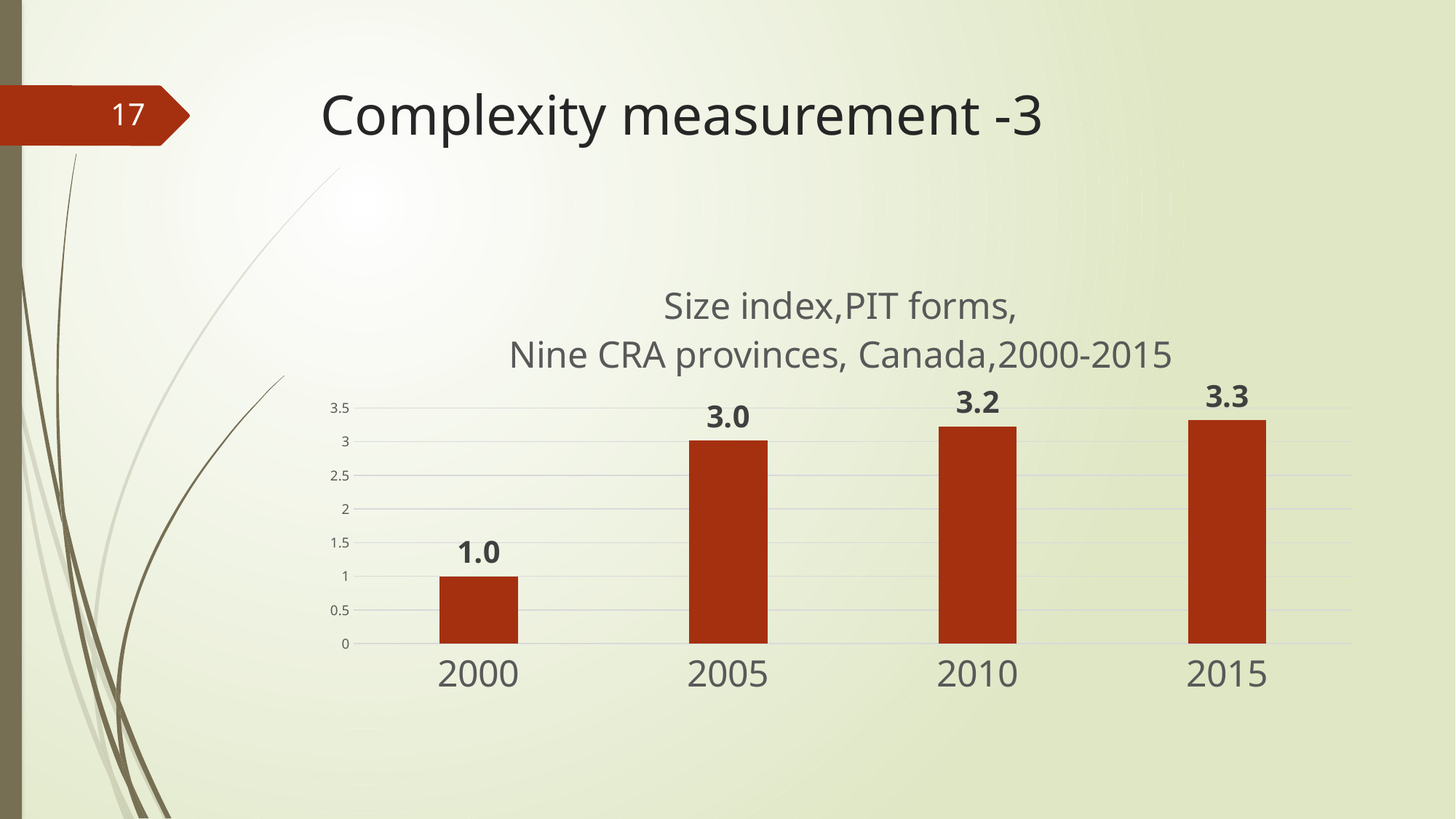
What is the difference between the size index values for 2005 and 2000? 2.0 Which year has the highest size index value? 2015 Which year has a larger size index value, 2000 or 2010? 2010 What is the size index value for 2010? 3.2 What is the size index value for 2005? 3.0 What is the size index value for 2000? 1.0 How many years are shown on the x axis of the chart? 4 Which year has the lowest size index value? 2000 What kind of chart is shown on the slide? Bar chart What is the size index value for 2015? 3.3 What is the difference between the size index values for 2015 and 2010? 0.1 Do the size index values rise or fall from 2000 to 2015? Rise